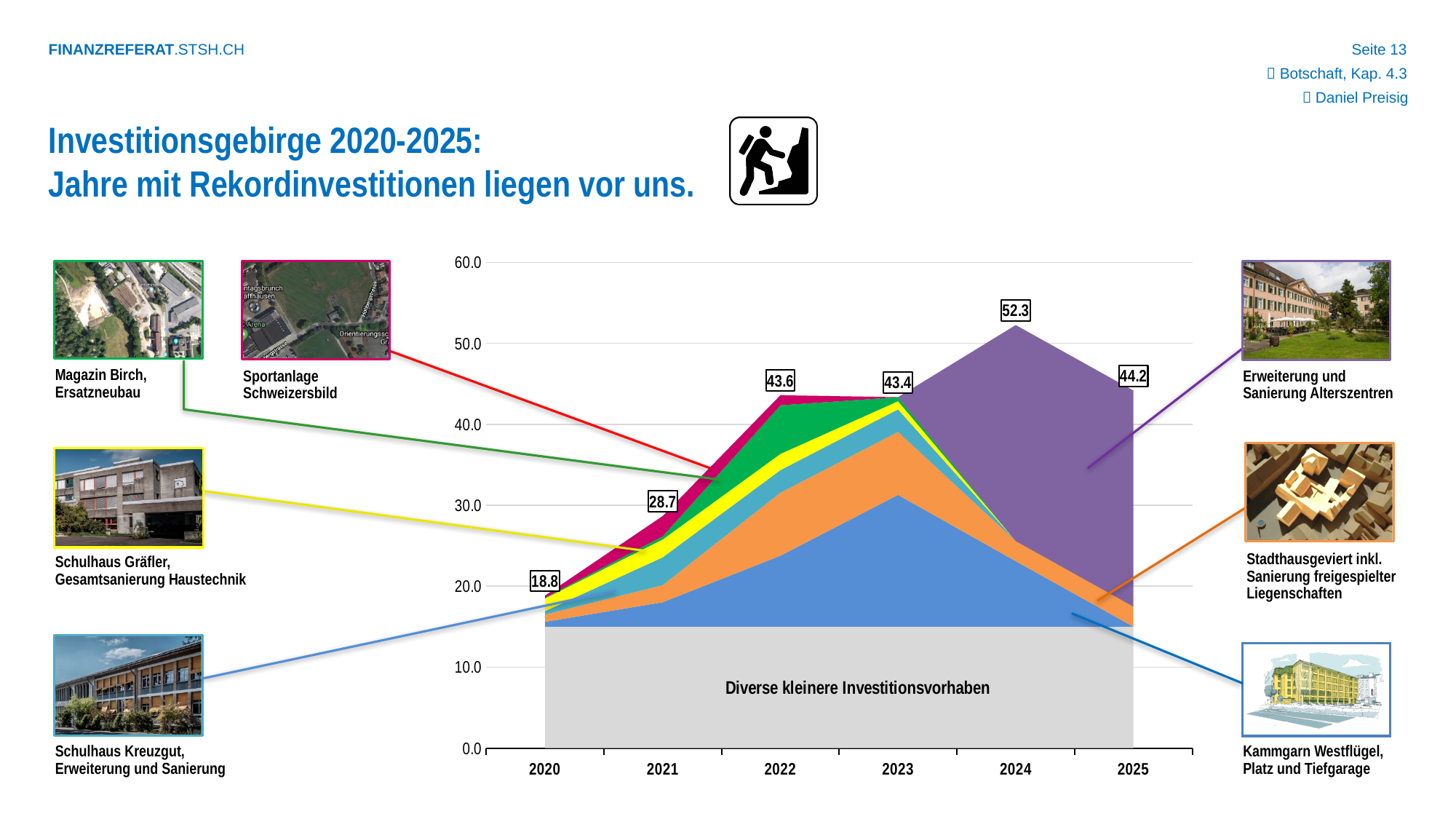
What is the total value shown for 2025? 44.2 What kind of chart is shown on the slide? Stacked area chart Is the total value for 2021 greater or less than 20.0? greater Which year has the larger total, 2022 or 2023? 2022 What label is printed inside the grey area at the bottom of the chart? Diverse kleinere Investitionsvorhaben What is the total value shown for 2020? 18.8 How many years are shown on the x axis? 6 What is the difference between the total for 2024 and the total for 2020? 33.5 Which year has the lowest total value? 2020 Which year has the highest total value? 2024 What is the difference between the total for 2022 and the total for 2021? 14.9 What is the total value shown for 2024? 52.3